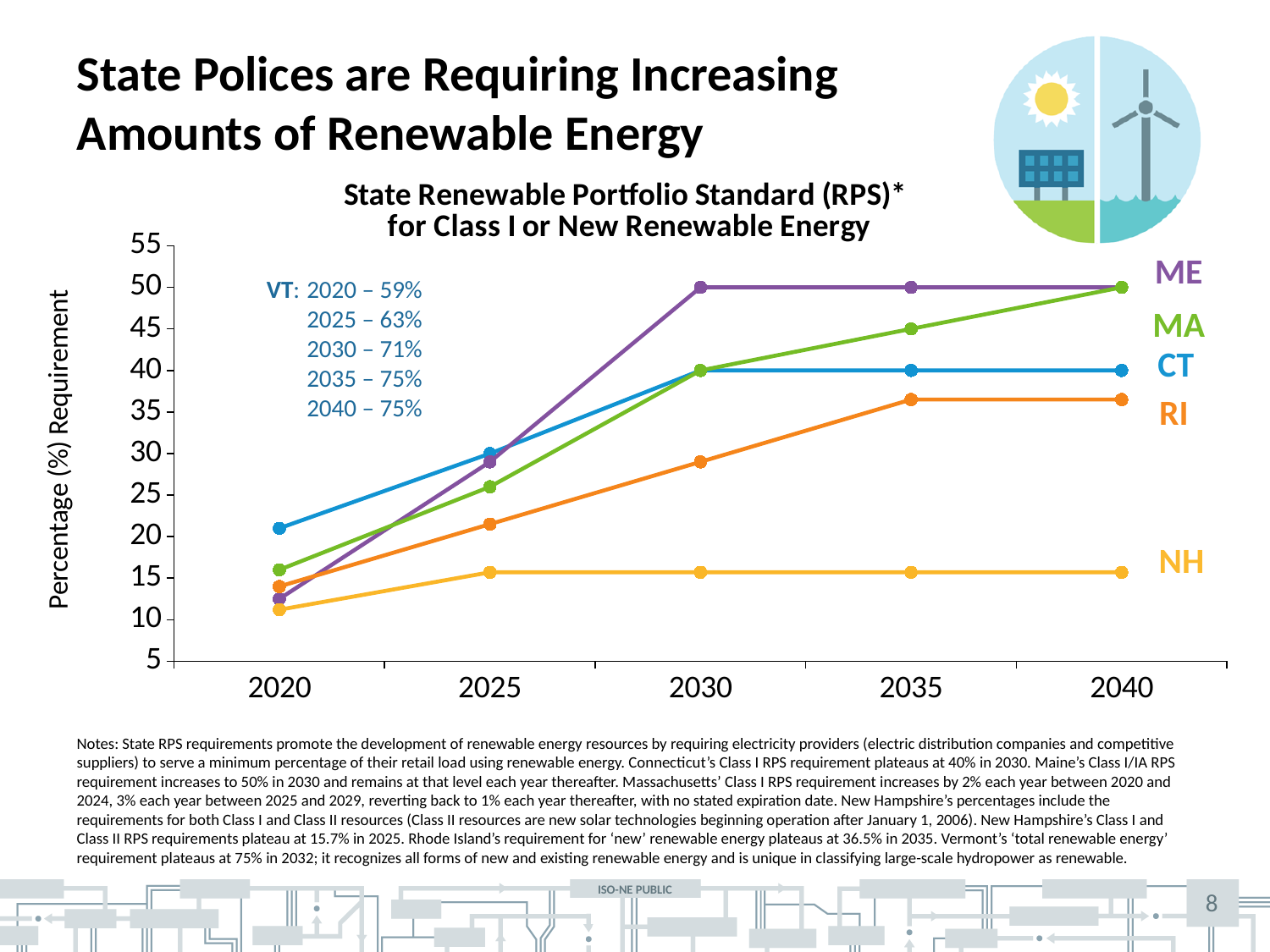
How many years are shown along the x axis of the chart? 5 What is the RPS requirement for MA in 2035? 45 In 2030, which state has the larger RPS requirement, ME or RI? ME How many state series are plotted on the chart? 5 Is the value for RI in 2030 greater or less than 25? greater What is the RPS requirement for CT in 2040? 40 Which state has the highest RPS requirement in 2020? CT Which state has the lowest RPS requirement in 2040? NH What is the RPS requirement for ME in 2030? 50 Does the ME line rise or fall between 2020 and 2030? rise What is the difference between the ME and CT requirements in 2030? 10 What kind of chart is shown on the slide? line chart